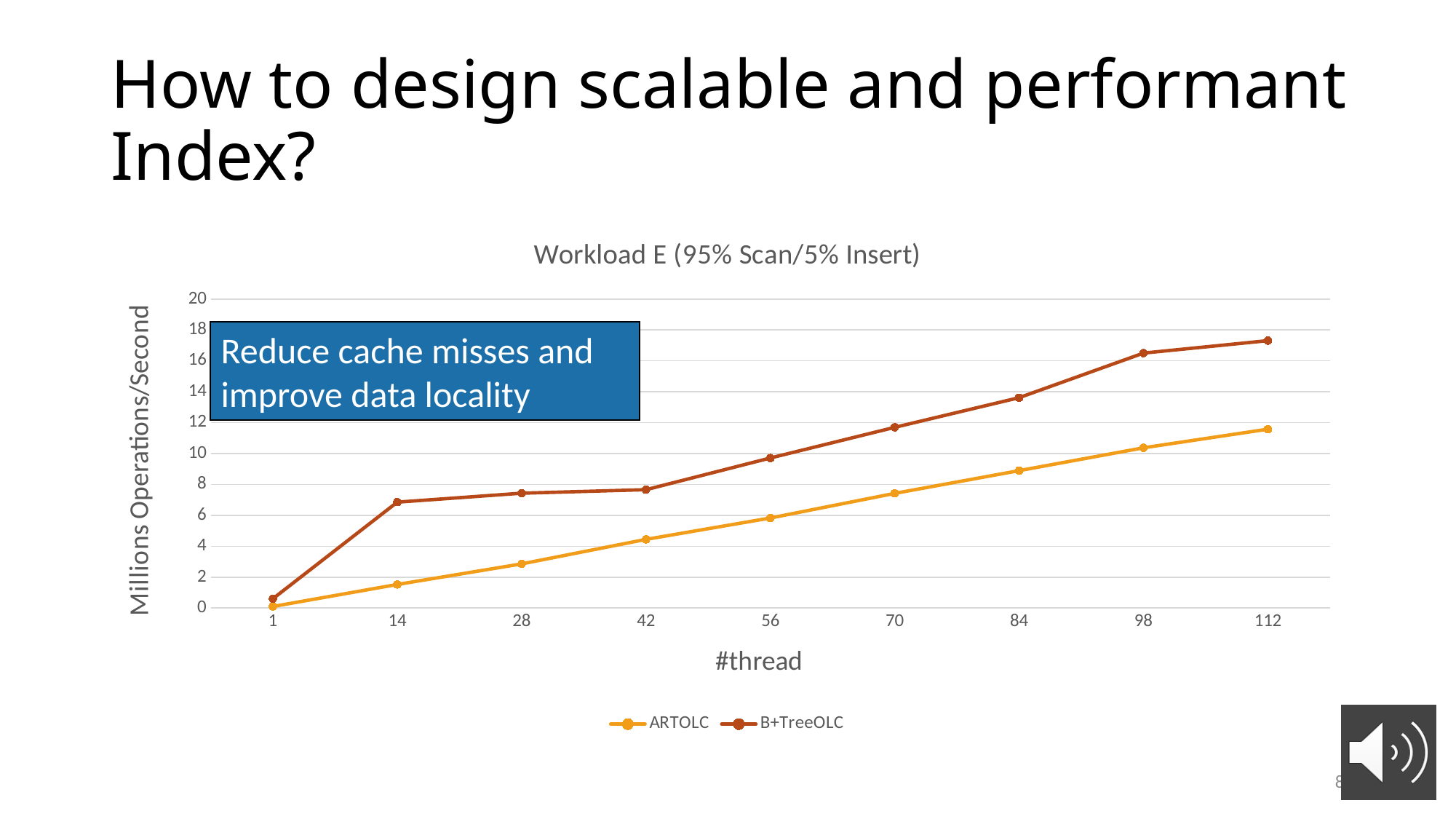
At 56 threads, which series has the higher value, ARTOLC or B+TreeOLC? B+TreeOLC Is the value for ARTOLC at 112 threads greater or less than 10? greater Is the value for B+TreeOLC at 112 threads greater or less than 16? greater How many thread counts are plotted along the x axis? 9 How many series does the legend list? 2 What is the label of the y axis? Millions Operations/Second At which thread count does ARTOLC reach its highest value? 112 Do the values for ARTOLC rise or fall as the number of threads increases? rise Is the value for ARTOLC at 28 threads greater or less than 4? less What kind of chart is shown on the slide? line chart What is the title of the chart? Workload E (95% Scan/5% Insert)